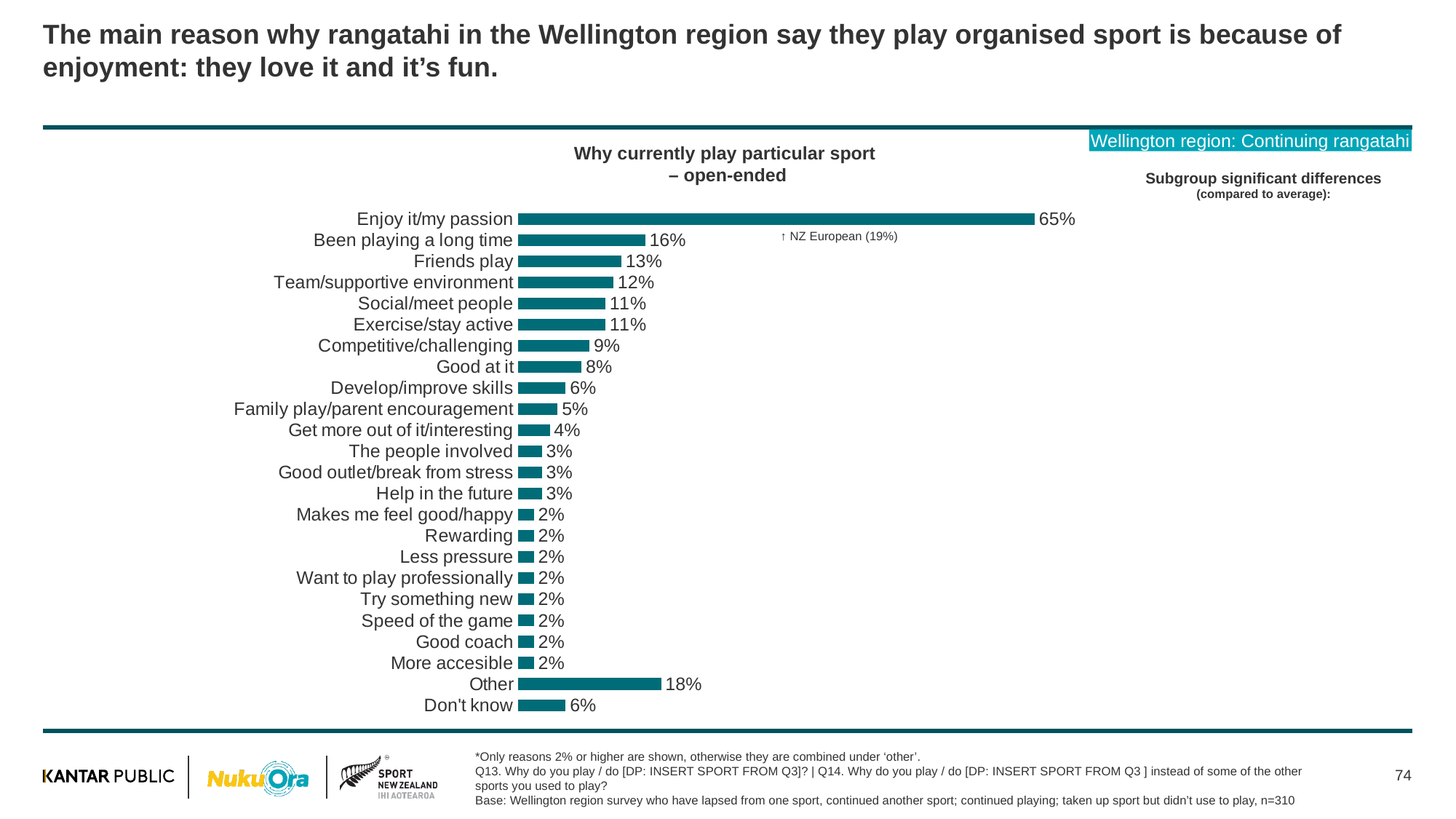
What is the difference between 'Enjoy it/my passion' and 'Been playing a long time'? 49 percentage points What is the value for 'Competitive/challenging'? 9% What is the difference between 'Friends play' and 'Good at it'? 5 percentage points Which reason has the highest percentage in the chart? Enjoy it/my passion What percentage is shown for 'Other'? 18% Which is larger, the value for 'Other' or the value for 'Friends play'? Other What percentage of respondents said they play their sport because they enjoy it / it is their passion? 65% How many categories are shown in the chart? 24 What is the title of the chart? Why currently play particular sport – open-ended Which is larger, 'Develop/improve skills' or 'Family play/parent encouragement'? Develop/improve skills What is the value for 'Been playing a long time'? 16% What type of chart is shown on the slide? Bar chart